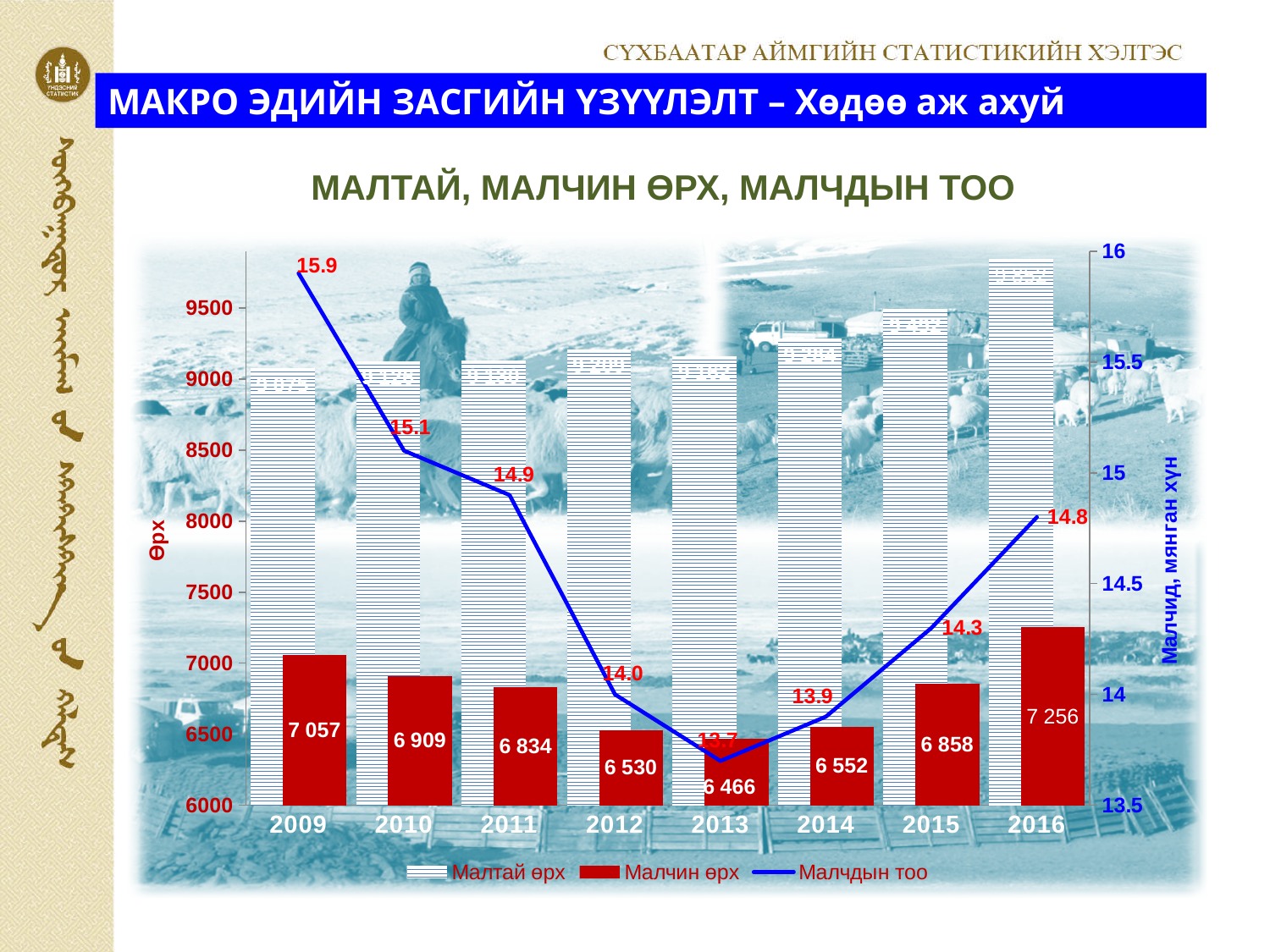
How many years are shown on the x axis? 8 Is the value of Малтай өрх for 2016 greater or less than 9500? greater In which year is Малчдын тоо the highest? 2009 What is the value of Малчдын тоо for 2009? 15.9 What is the value of Малчин өрх for 2016? 7 256 What is the value of Малчдын тоо for 2016? 14.8 How many series does the legend list? 3 What is the value of Малчин өрх for 2009? 7 057 What is the difference between Малчин өрх in 2016 and in 2009? 199 Which year has a larger Малчин өрх value, 2010 or 2015? 2010 In which year is Малчин өрх the highest? 2016 In which year is Малчин өрх the lowest? 2013